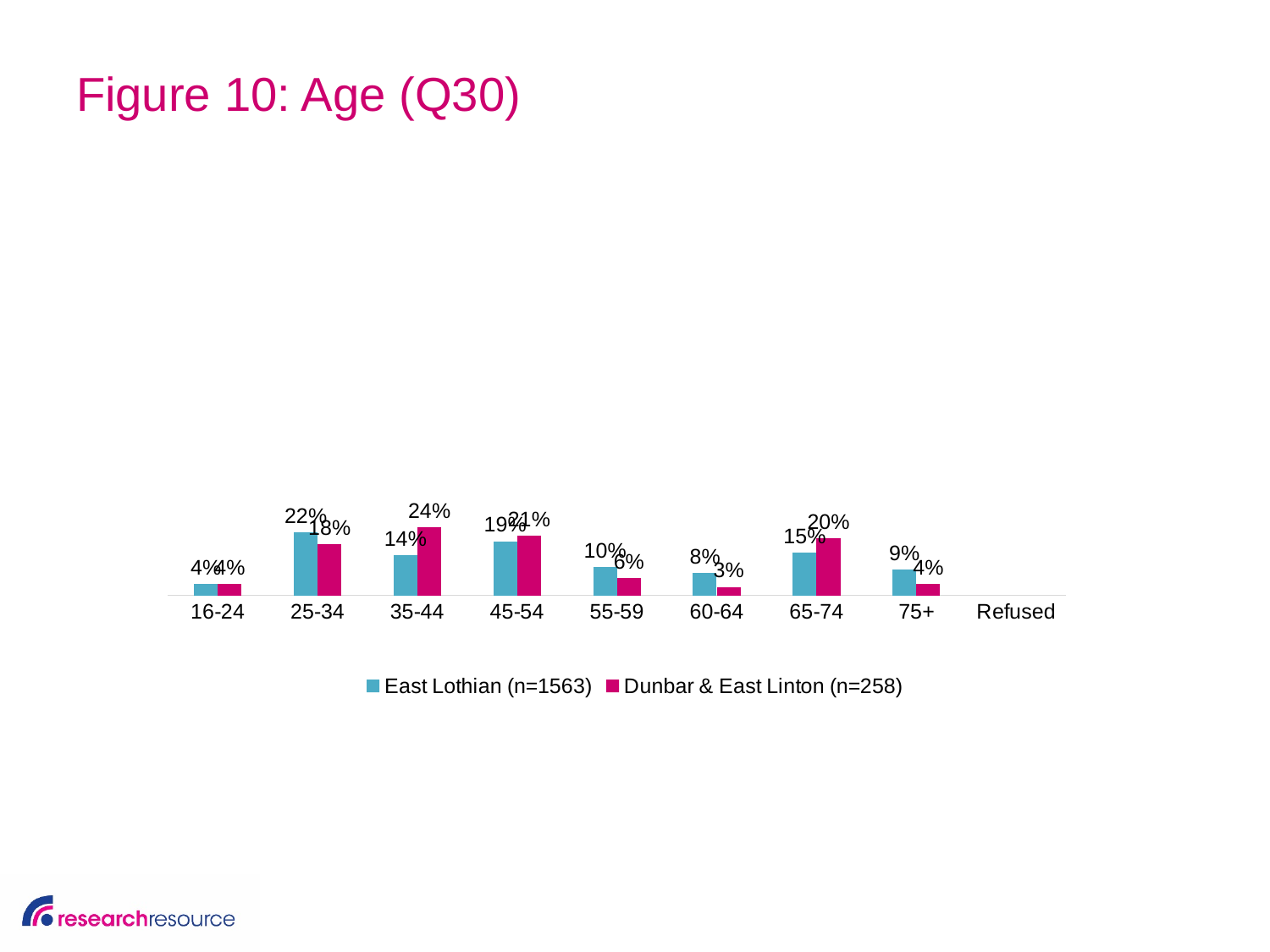
What is the Dunbar & East Linton (n=258) value for the 35-44 age group? 24% What kind of chart is shown on the slide? Bar chart How many age categories are shown on the x axis? 9 What is the difference between the Dunbar & East Linton (n=258) and East Lothian (n=1563) values for the 35-44 age group? 10 percentage points What is the East Lothian (n=1563) value for the 55-59 age group? 10% What is the East Lothian (n=1563) value for the 25-34 age group? 22% For the 60-64 age group, which series has the larger value: East Lothian (n=1563) or Dunbar & East Linton (n=258)? East Lothian (n=1563) Which age group has the highest Dunbar & East Linton (n=258) value? 35-44 How many series does the legend list? 2 Which age group has the highest East Lothian (n=1563) value? 25-34 What is the East Lothian (n=1563) value for the 75+ age group? 9% What is the Dunbar & East Linton (n=258) value for the 60-64 age group? 3%